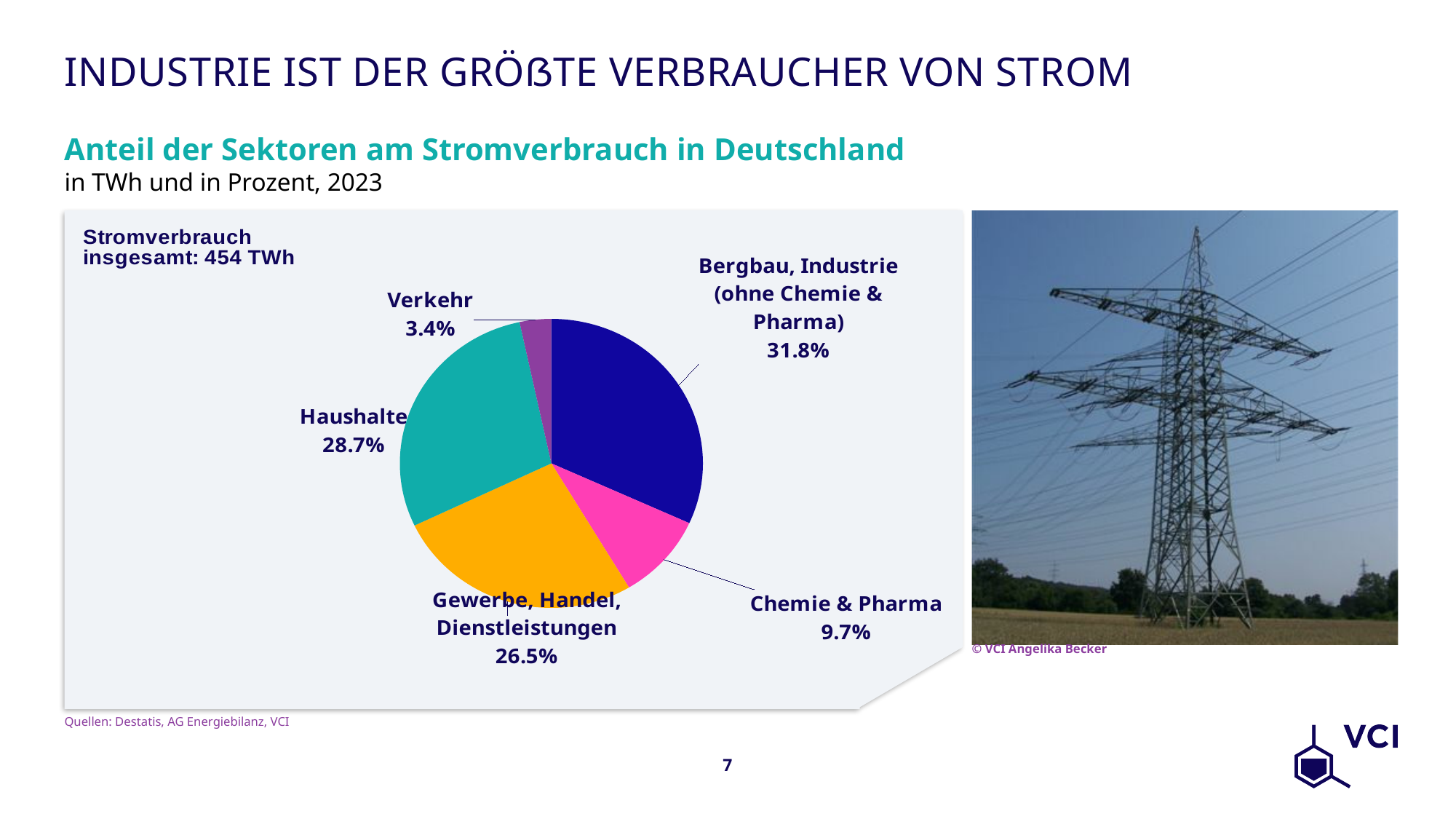
What is the total electricity consumption stated on the chart? 454 TWh What share of electricity consumption does the Haushalte slice represent? 28.7% What kind of chart is shown on the slide? Pie chart What colour is the Haushalte slice? Teal What share is shown for Verkehr? 3.4% What share is shown for Chemie & Pharma? 9.7% What is the difference in percentage points between Haushalte and Gewerbe, Handel, Dienstleistungen? 2.2 percentage points Which sector has the smallest share of electricity consumption? Verkehr What share is shown for Gewerbe, Handel, Dienstleistungen? 26.5% Which sector has the largest share of electricity consumption? Bergbau, Industrie (ohne Chemie & Pharma) How many sectors are shown in the pie chart? 5 Which has a larger share: Chemie & Pharma or Verkehr? Chemie & Pharma